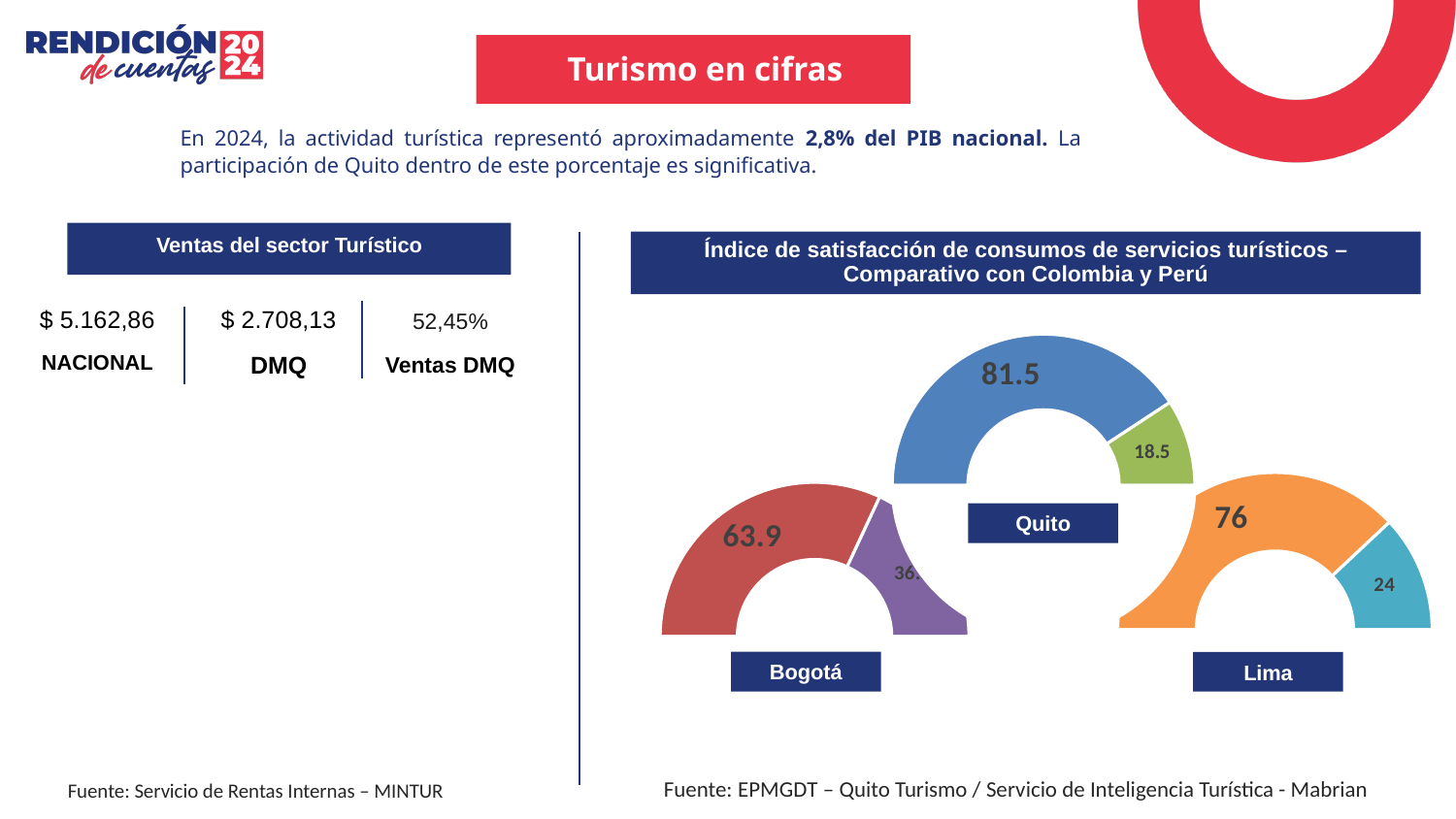
How many cities are compared in the satisfaction index chart? 3 In the satisfaction index chart, which is larger, the satisfaction value for Quito or for Bogotá? Quito In the satisfaction index chart, what is the smaller (teal) segment value shown for Lima? 24 In the satisfaction index chart, what is the satisfaction value shown for Lima? 76 In the satisfaction index chart, what is the smaller (green) segment value shown for Quito? 18.5 What is the title of the chart on the right side of the slide? Índice de satisfacción de consumos de servicios turísticos – Comparativo con Colombia y Perú In the satisfaction index chart, which city has the highest satisfaction value? Quito In the satisfaction index chart, what is the difference between the satisfaction values of Lima and Bogotá? 12.1 In the satisfaction index chart, what is the difference between the satisfaction values of Quito and Lima? 5.5 In the satisfaction index chart, what is the satisfaction value shown for Quito? 81.5 In the satisfaction index chart, what is the satisfaction value shown for Bogotá? 63.9 In the satisfaction index chart, which city has the lowest satisfaction value? Bogotá